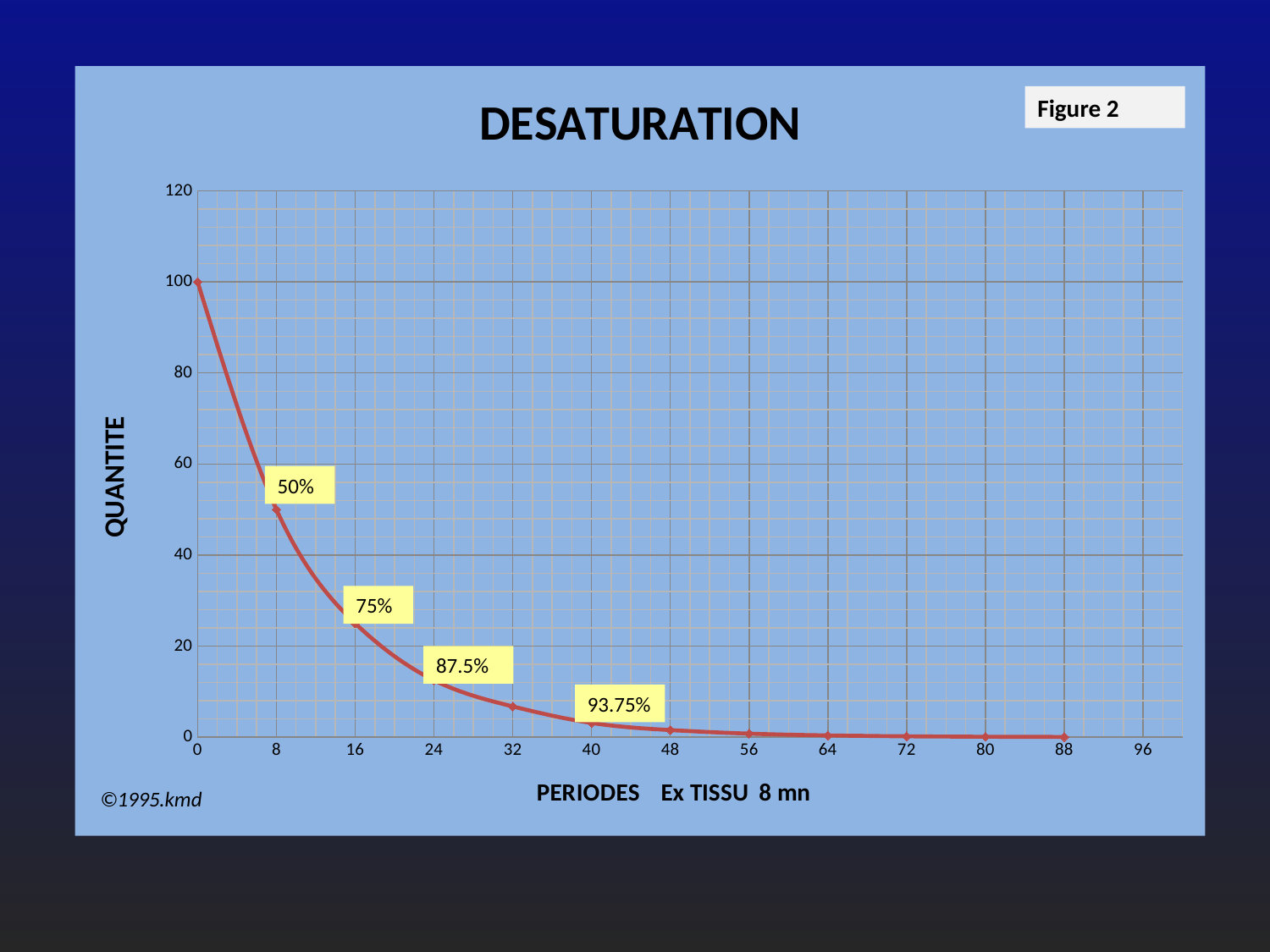
Is the value at period 16 greater or less than 40? less How many data points are plotted on the line? 12 What is the title of the chart? DESATURATION What is the value of QUANTITE at period 0? 100 Do the values rise or fall as the periods increase along the x axis? fall Is the value at period 24 greater or less than 20? less Is the value at period 8 greater or less than 40? greater What kind of chart is shown on the slide? line chart Which has the larger value, period 8 or period 16? period 8 At which period is the value highest? 0 What is the label on the y axis? QUANTITE